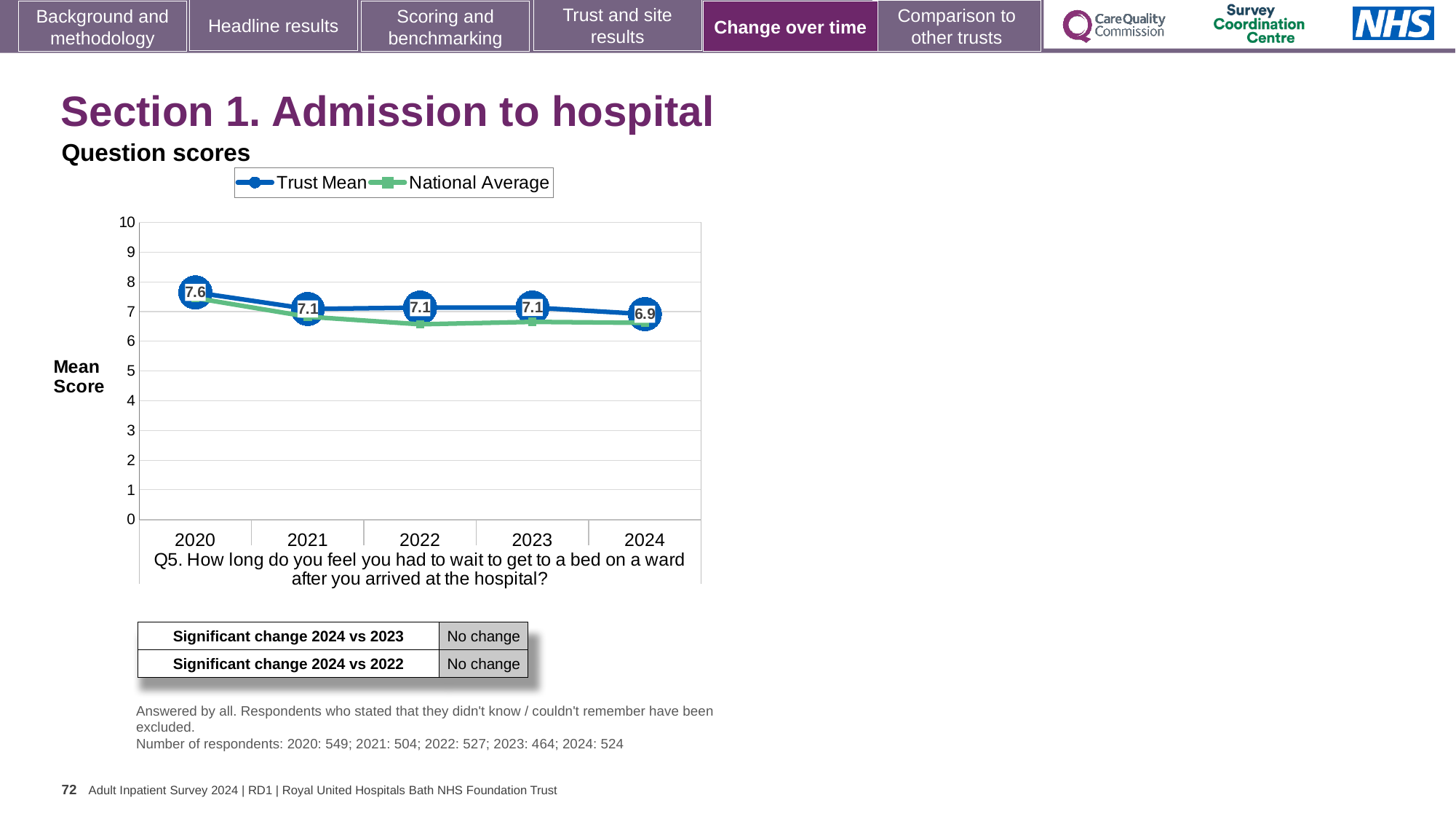
What is the difference between the Trust Mean in 2020 and in 2024? 0.7 What is the Trust Mean value for 2022? 7.1 How many years are shown on the x axis of the chart? 5 In which year is the Trust Mean highest? 2020 What kind of chart is shown on the slide? line chart In which year is the Trust Mean lowest? 2024 How many series does the chart legend list? 2 Is the National Average value for 2022 greater or less than 7? less What is the Trust Mean value for 2020? 7.6 Does the Trust Mean rise or fall from 2020 to 2024? fall What is the Trust Mean value for 2024? 6.9 Which is larger, the Trust Mean in 2020 or the Trust Mean in 2021? 2020